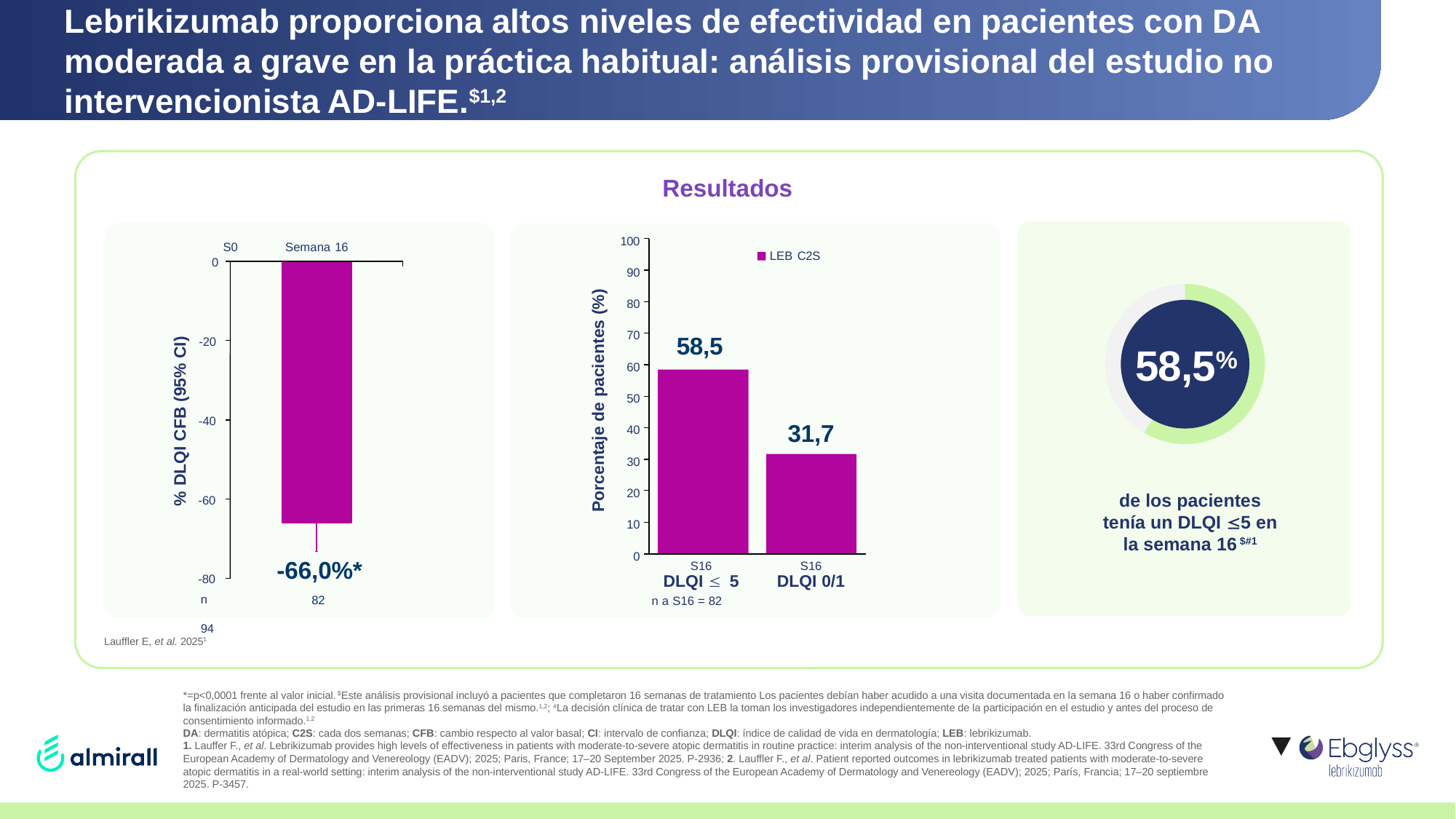
In the middle chart (Porcentaje de pacientes), which is larger: DLQI ≤ 5 or DLQI 0/1? DLQI ≤ 5 In the middle chart (Porcentaje de pacientes), which category has the highest value? DLQI ≤ 5 What kind of chart is the left chart (% DLQI CFB)? bar chart In the middle chart (Porcentaje de pacientes), what is the value for DLQI 0/1 at S16? 31,7 In the middle chart (Porcentaje de pacientes), how many bars are plotted? 2 In the left chart (% DLQI CFB), is the value for Semana 16 greater or less than -60? less In the middle chart (Porcentaje de pacientes), how many series does the legend list? 1 In the middle chart (Porcentaje de pacientes), what is the value for DLQI ≤ 5 at S16? 58,5 In the left chart (% DLQI CFB), what value is labelled on the bar for Semana 16? -66,0% In the middle chart (Porcentaje de pacientes), what is the difference between the DLQI ≤ 5 value and the DLQI 0/1 value? 26,8 In the right donut chart, what percentage of patients had a DLQI ≤5 at week 16? 58,5% In the middle chart (Porcentaje de pacientes), what is the legend entry? LEB C2S